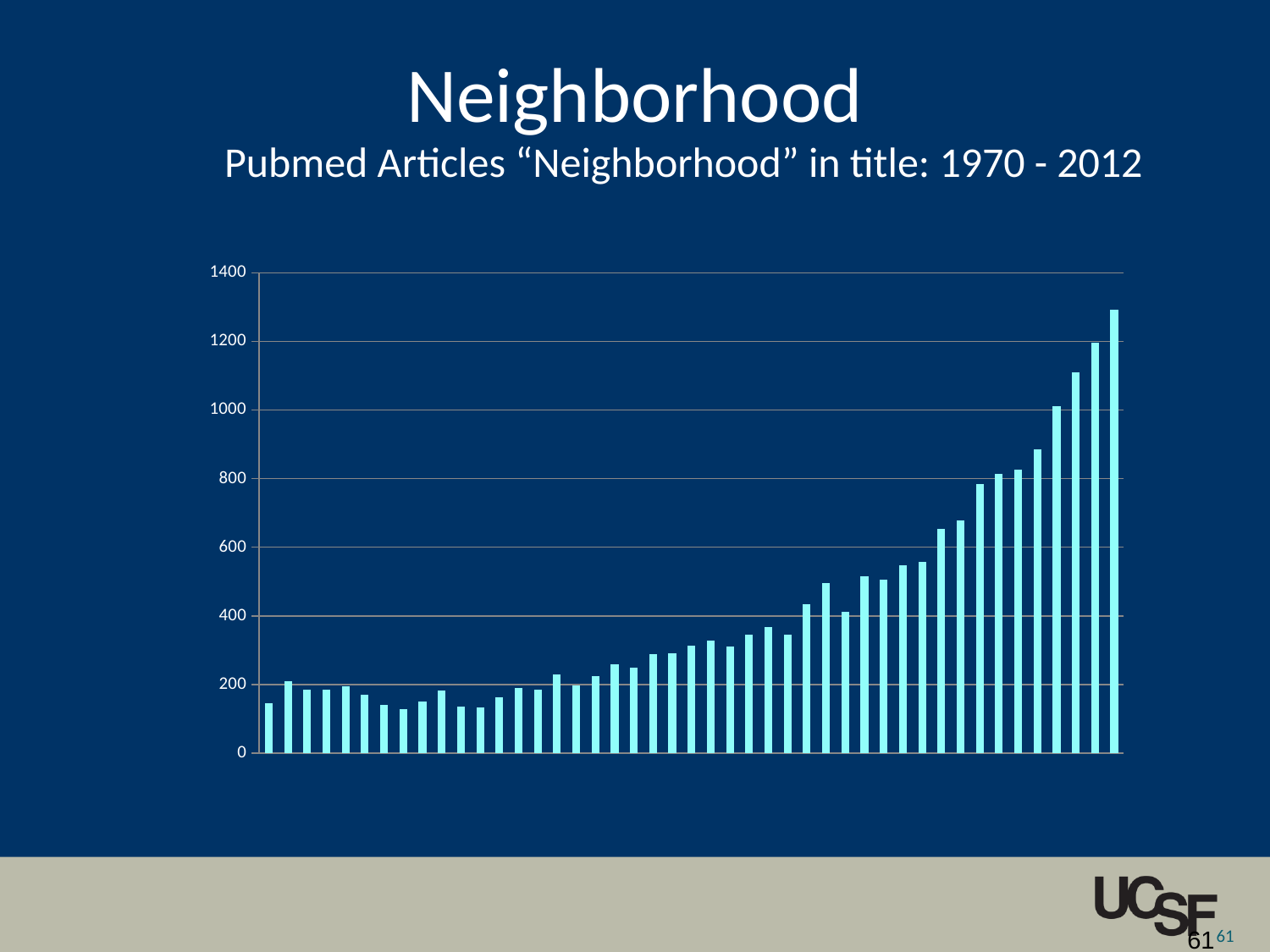
Is the value of the rightmost (tallest) bar greater or less than 1200? greater Is the value of the rightmost bar greater or less than 1400? less Which bar is the tallest in the chart? the rightmost bar What does the subtitle say the chart shows? Pubmed Articles "Neighborhood" in title: 1970 - 2012 What is the title of the slide's chart? Neighborhood What kind of chart is shown on the slide? bar chart What is the highest value shown on the vertical axis? 1400 Which is larger, the leftmost bar or the rightmost bar? the rightmost bar Is the value of the leftmost bar greater or less than 200? less Overall, do the bar values rise or fall from left to right across the chart? rise